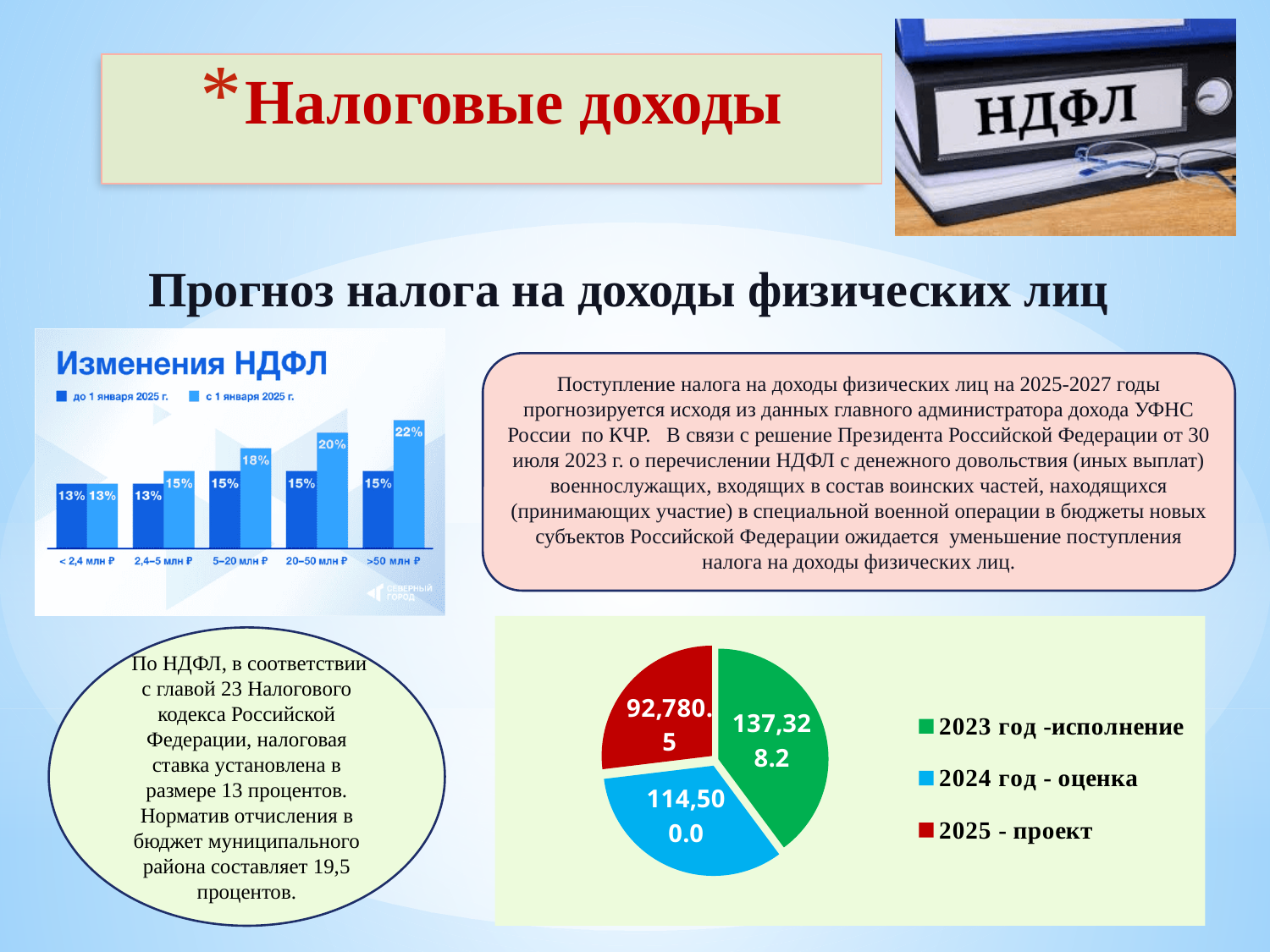
On the bar chart 'Изменения НДФЛ', what is the value for the 5–20 млн ₽ category in the 'до 1 января 2025 г.' series? 15% On the pie chart, which category has the largest slice? 2023 год - исполнение On the pie chart, what colour is the slice for 2024 год - оценка? Blue On the bar chart 'Изменения НДФЛ', what is the value for the >50 млн ₽ category in the 'с 1 января 2025 г.' series? 22% On the bar chart 'Изменения НДФЛ', do the values of the 'с 1 января 2025 г.' series rise or fall from left to right? Rise On the pie chart, what is the difference between the 2023 год - исполнение value and the 2025 - проект value? 44,547.7 On the pie chart, what is the value for 2024 год - оценка? 114,500.0 On the pie chart, which category has the smallest slice? 2025 - проект On the bar chart 'Изменения НДФЛ', how many series does the legend list? 2 On the pie chart, what is the value for 2023 год - исполнение? 137,328.2 On the pie chart, what is the value for 2025 - проект? 92,780.5 On the pie chart, how many slices are there? 3